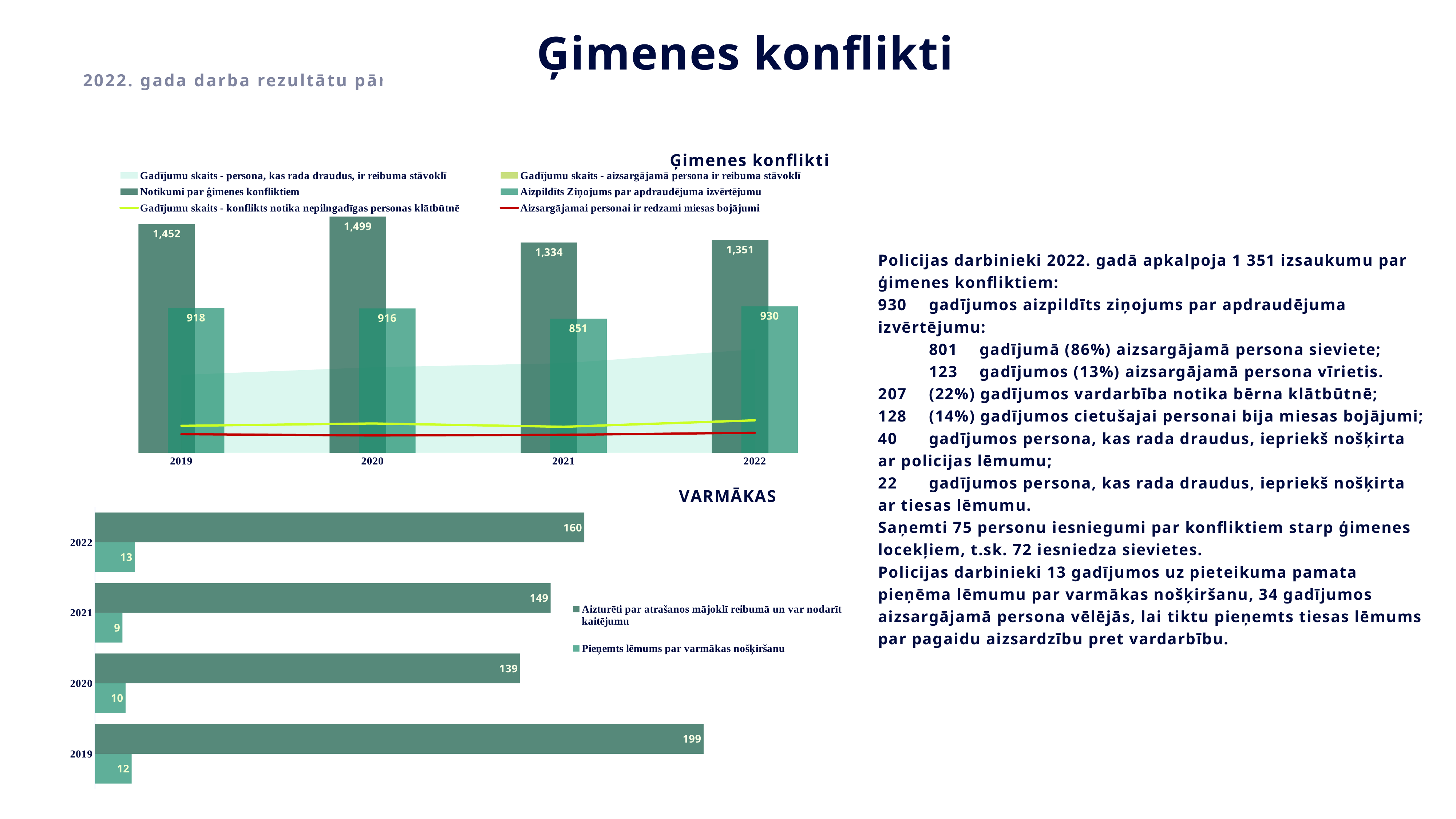
What kind of chart is the 'VARMĀKAS' chart? Bar chart In the 'Ģimenes konflikti' chart, how many series does the legend list? 6 In the 'Ģimenes konflikti' chart, what is the value of 'Notikumi par ģimenes konfliktiem' for 2020? 1,499 In the 'Ģimenes konflikti' chart, what is the difference between 'Notikumi par ģimenes konfliktiem' in 2019 and 2022? 101 In the 'Ģimenes konflikti' chart, what is the value of 'Aizpildīts Ziņojums par apdraudējuma izvērtējumu' for 2021? 851 In the 'VARMĀKAS' chart, what is the difference between 'Aizturēti par atrašanos mājoklī reibumā un var nodarīt kaitējumu' in 2022 and 2021? 11 In the 'Ģimenes konflikti' chart, which year has the highest value for 'Notikumi par ģimenes konfliktiem'? 2020 In the 'Ģimenes konflikti' chart, which year has the lowest value for 'Aizpildīts Ziņojums par apdraudējuma izvērtējumu'? 2021 In the 'VARMĀKAS' chart, is the value of 'Pieņemts lēmums par varmākas nošķiršanu' larger in 2022 or in 2020? 2022 In the 'VARMĀKAS' chart, what is the value of 'Aizturēti par atrašanos mājoklī reibumā un var nodarīt kaitējumu' for 2019? 199 In the 'VARMĀKAS' chart, which year has the lowest value for 'Aizturēti par atrašanos mājoklī reibumā un var nodarīt kaitējumu'? 2020 In the 'VARMĀKAS' chart, what is the value of 'Pieņemts lēmums par varmākas nošķiršanu' for 2021? 9